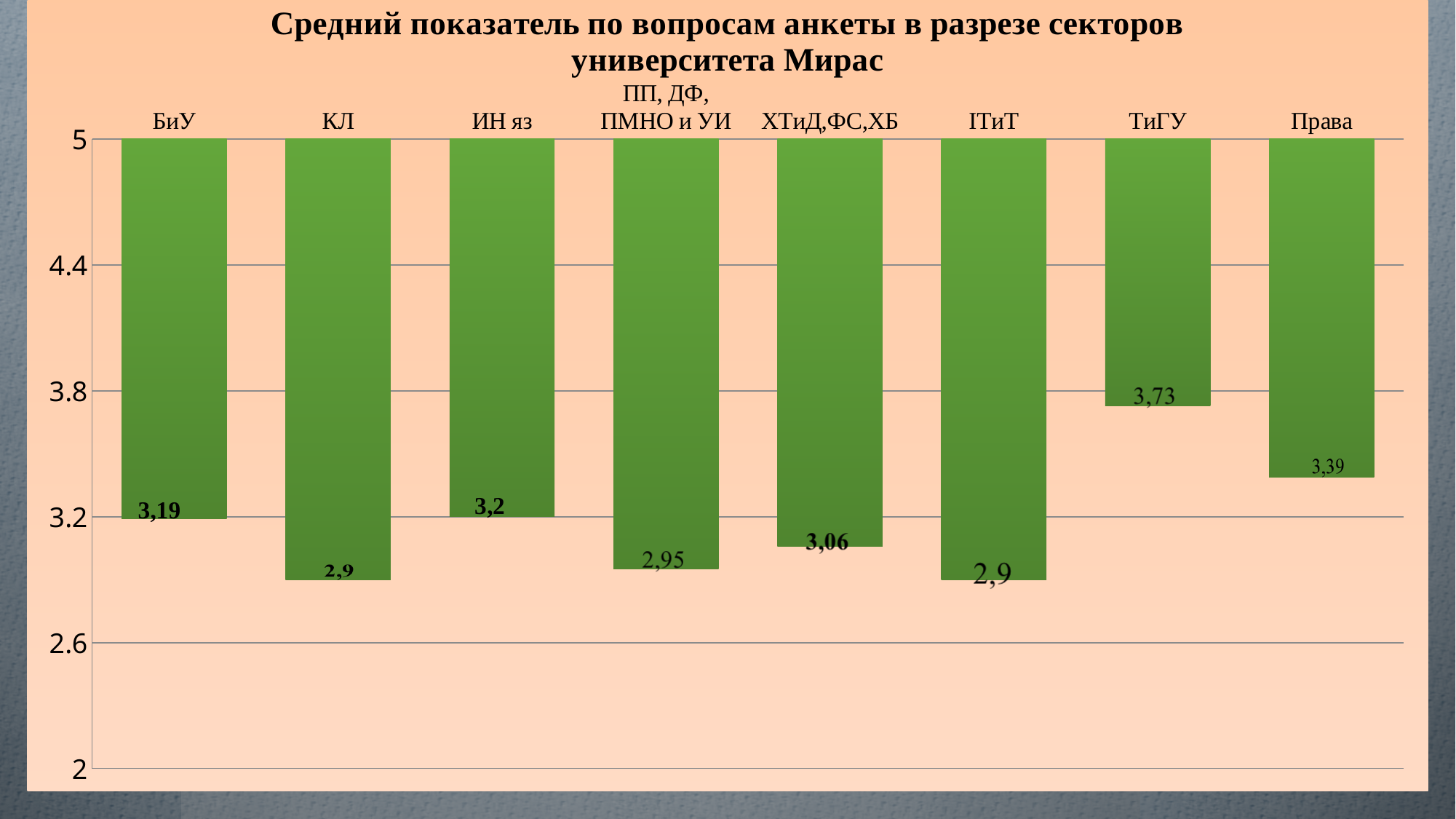
What is the difference between the values for БиУ and КЛ? 0,29 How many sectors are shown on the chart? 8 What is the title of the chart? Средний показатель по вопросам анкеты в разрезе секторов университета Мирас What is the value for Права? 3,39 What is the value for ХТиД,ФС,ХБ? 3,06 What is the difference between the values for ТиГУ and Права? 0,34 Which is larger, the value for ИН яз or the value for IТиТ? ИН яз Is the value for Права greater or less than 3.8? less What is the value for ТиГУ? 3,73 What is the value for ПП, ДФ, ПМНО и УИ? 2,95 Which sector has the highest value? ТиГУ What kind of chart is this? bar chart